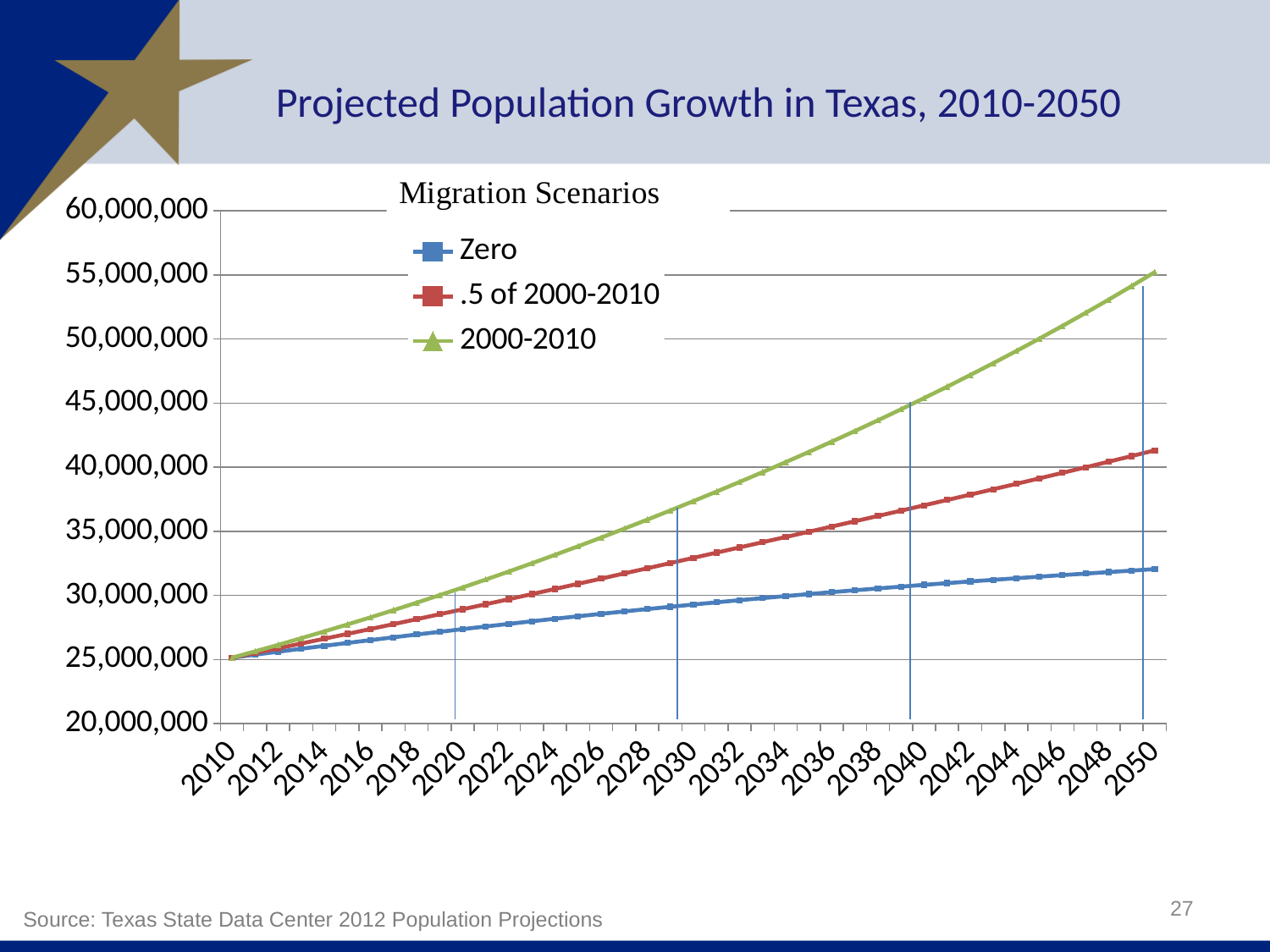
Do the values for the 2000-2010 scenario rise or fall from 2010 to 2050? rise In 2040, which is larger: the value for the 2000-2010 scenario or the value for the Zero scenario? 2000-2010 Is the value for the 2000-2010 scenario in 2030 greater or less than 35,000,000? greater Is the value for the Zero scenario in 2030 greater or less than 30,000,000? less How many year labels are shown on the x axis? 21 How many series does the legend list? 3 What are the three migration scenarios listed in the legend? Zero, .5 of 2000-2010, 2000-2010 Which migration scenario has the lowest projected population in 2050? Zero Which migration scenario has the highest projected population in 2050? 2000-2010 What kind of chart is shown on the slide? line chart What is the title of the chart's legend? Migration Scenarios Is the value for the .5 of 2000-2010 scenario in 2050 greater or less than 45,000,000? less